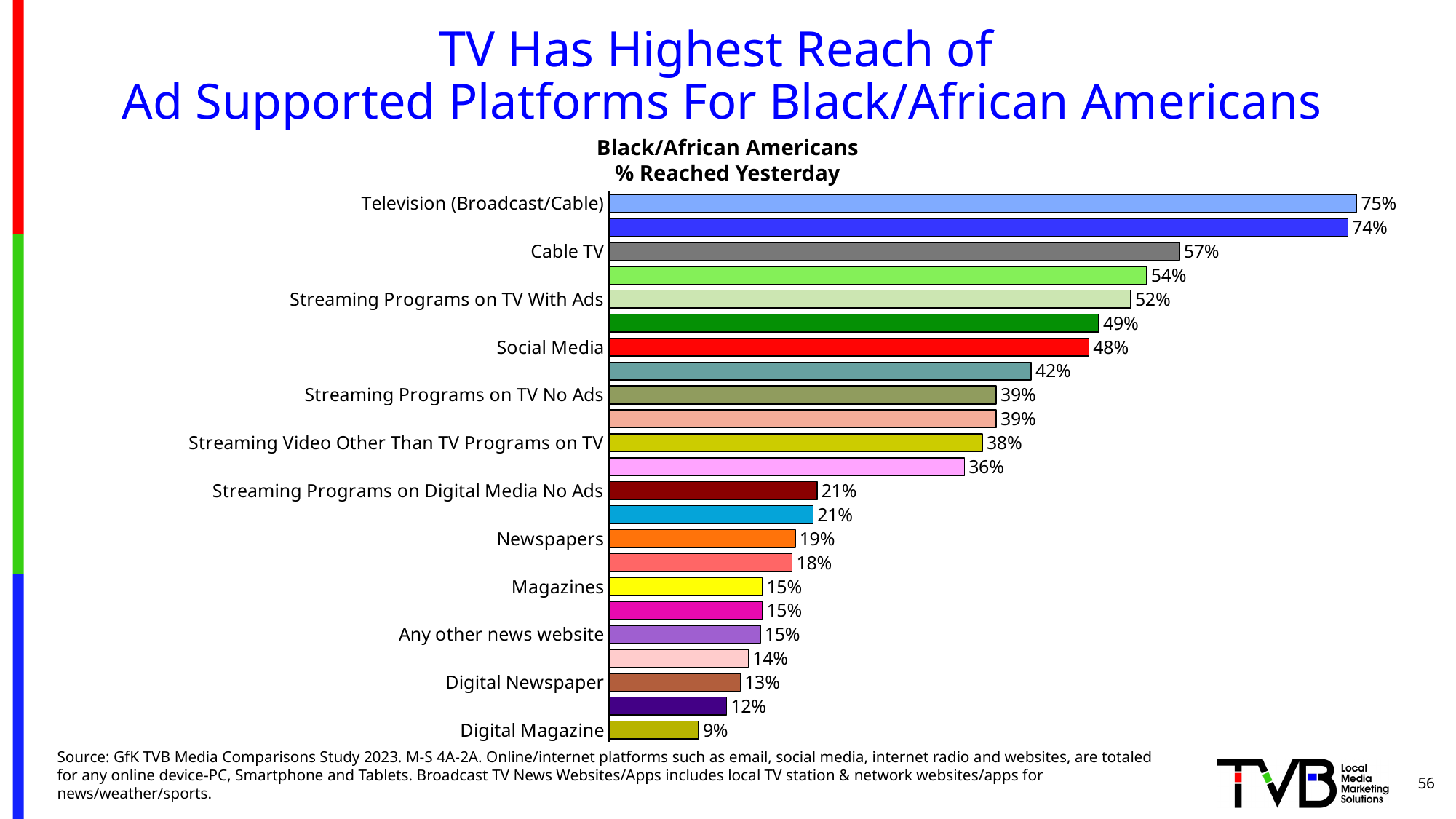
Which category has the lowest % Reached Yesterday? Digital Magazine Which is larger, the value for Streaming Programs on TV With Ads or the value for Social Media? Streaming Programs on TV With Ads What is the value shown for Digital Magazine? 9% What is the difference between the values for Television (Broadcast/Cable) and Cable TV? 18% What is the % Reached Yesterday value for Television (Broadcast/Cable)? 75% What type of chart is shown on the slide? Bar chart How many bars are plotted in the chart? 23 What is the value shown for Cable TV? 57% Which category has the highest % Reached Yesterday? Television (Broadcast/Cable) What is the value shown for Social Media? 48% What is the title printed directly above the chart? Black/African Americans % Reached Yesterday What is the difference between the values for Newspapers and Digital Newspaper? 6%